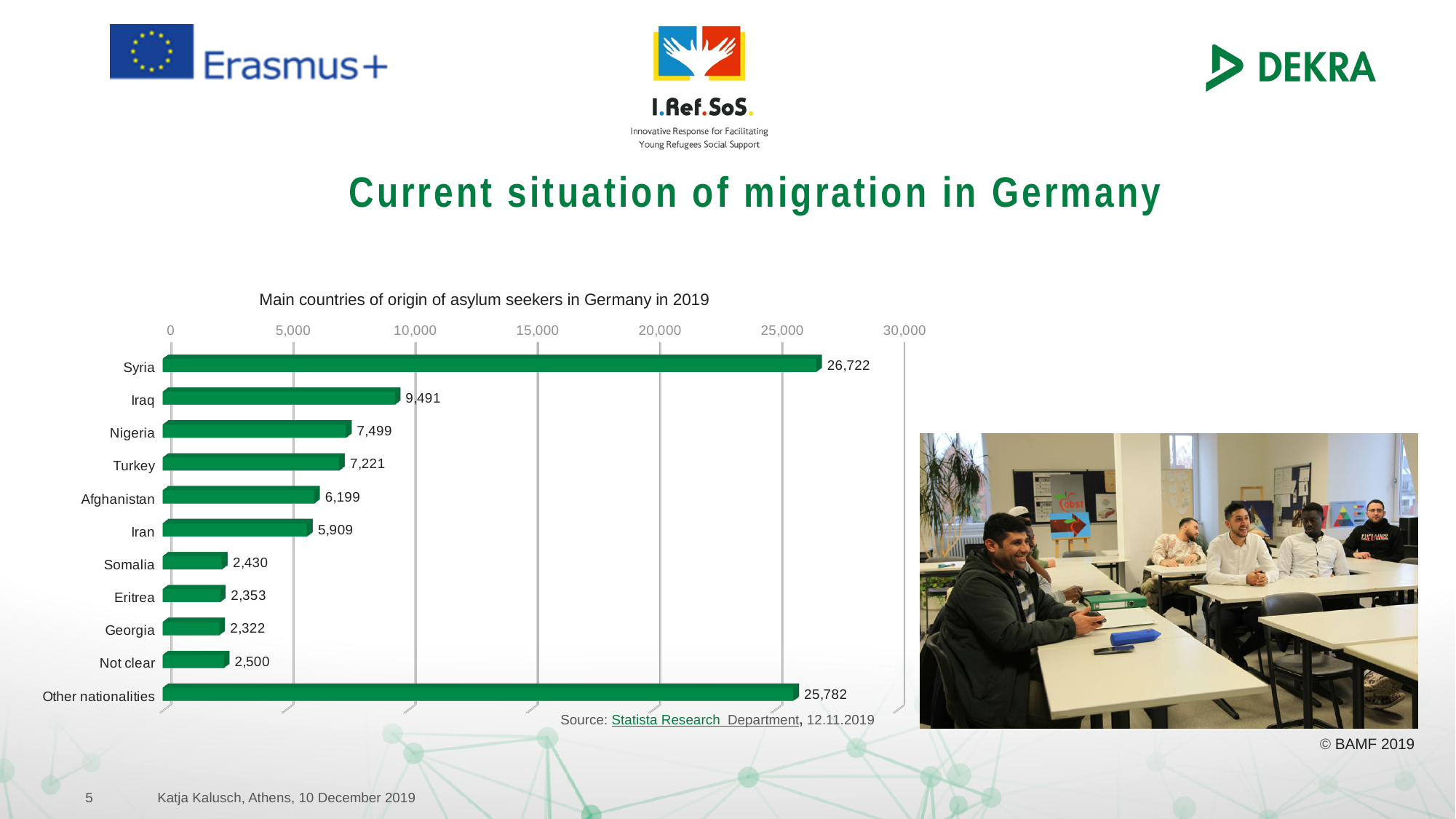
What is the value for Syria? 26,722 What is the title of the chart? Main countries of origin of asylum seekers in Germany in 2019 Which is larger, the value for Turkey or the value for Iran? Turkey What kind of chart is shown on the slide? bar chart How many categories are shown on the chart? 11 What is the difference between the values for Iraq and Nigeria? 1,992 What is the difference between the values for Syria and Other nationalities? 940 What is the value for Other nationalities? 25,782 Is the value for Iraq greater or less than 10,000? less Which category has the highest value? Syria Which category has the lowest value? Georgia What is the value for Afghanistan? 6,199